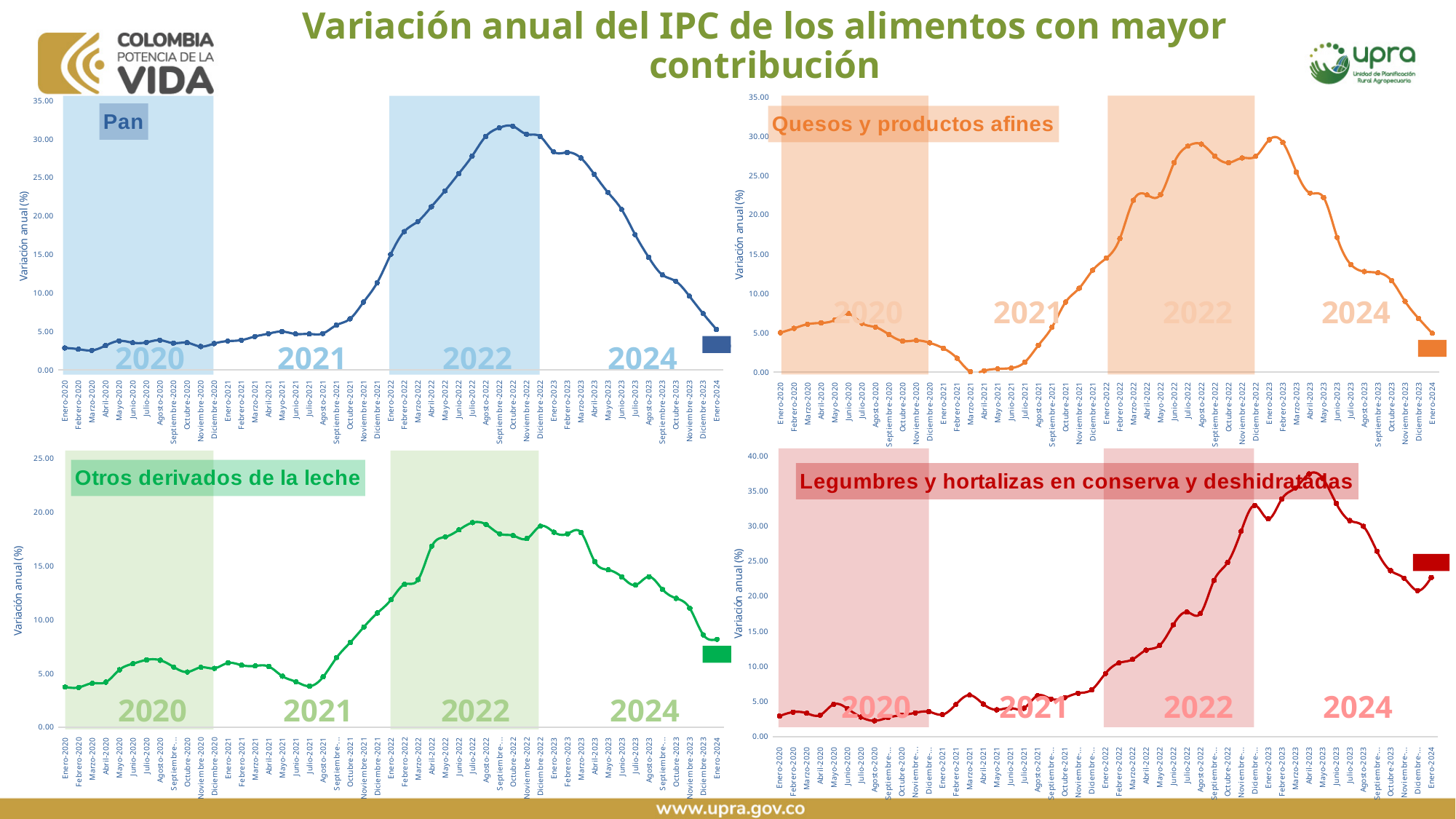
In the 'Legumbres y hortalizas en conserva y deshidratadas' chart, is the value for Enero-2024 greater or less than 20? greater In the 'Otros derivados de la leche' chart, is the value for Enero-2024 greater or less than 10? less In the 'Pan' chart, do the values rise or fall from Enero-2023 to Enero-2024? fall In the 'Quesos y productos afines' chart, is the value for Marzo-2021 greater or less than 5? less How many charts are shown on the slide? 4 What type of chart is used for the 'Pan' panel? line chart What is the label on the vertical axis of the 'Pan' chart? Variación anual (%)